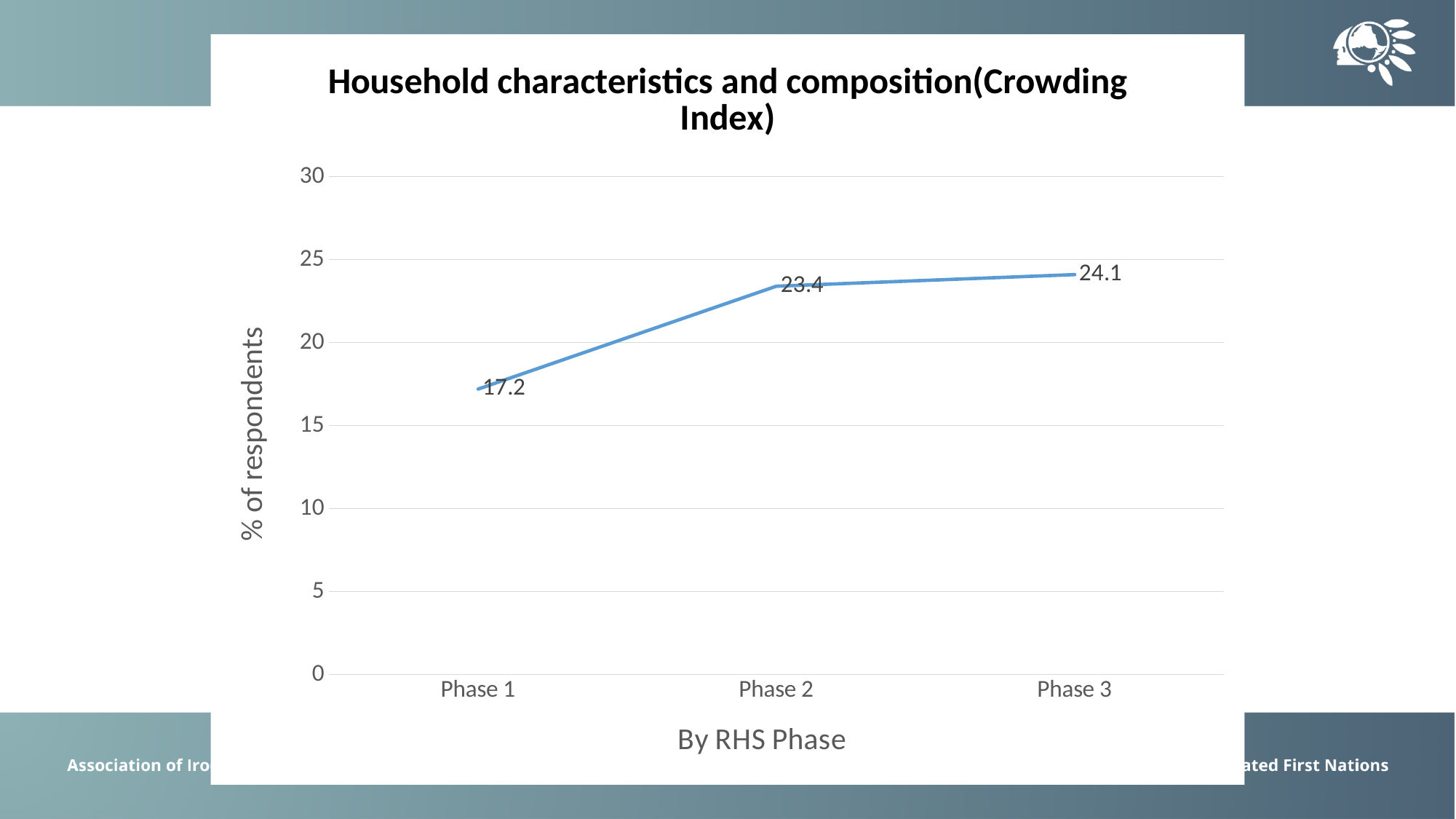
What is the difference between the values for Phase 2 and Phase 1? 6.2 How many phases are plotted on the x axis? 3 What is the value for Phase 1? 17.2 Which phase has the highest value? Phase 3 What is the value for Phase 3? 24.1 What is the difference between the values for Phase 3 and Phase 2? 0.7 What kind of chart is shown? line chart What is the value for Phase 2? 23.4 Which phase has the lowest value? Phase 1 Is the value for Phase 1 greater or less than 20? less Do the values rise or fall from Phase 1 to Phase 3? rise Which is larger, the value for Phase 1 or the value for Phase 2? Phase 2